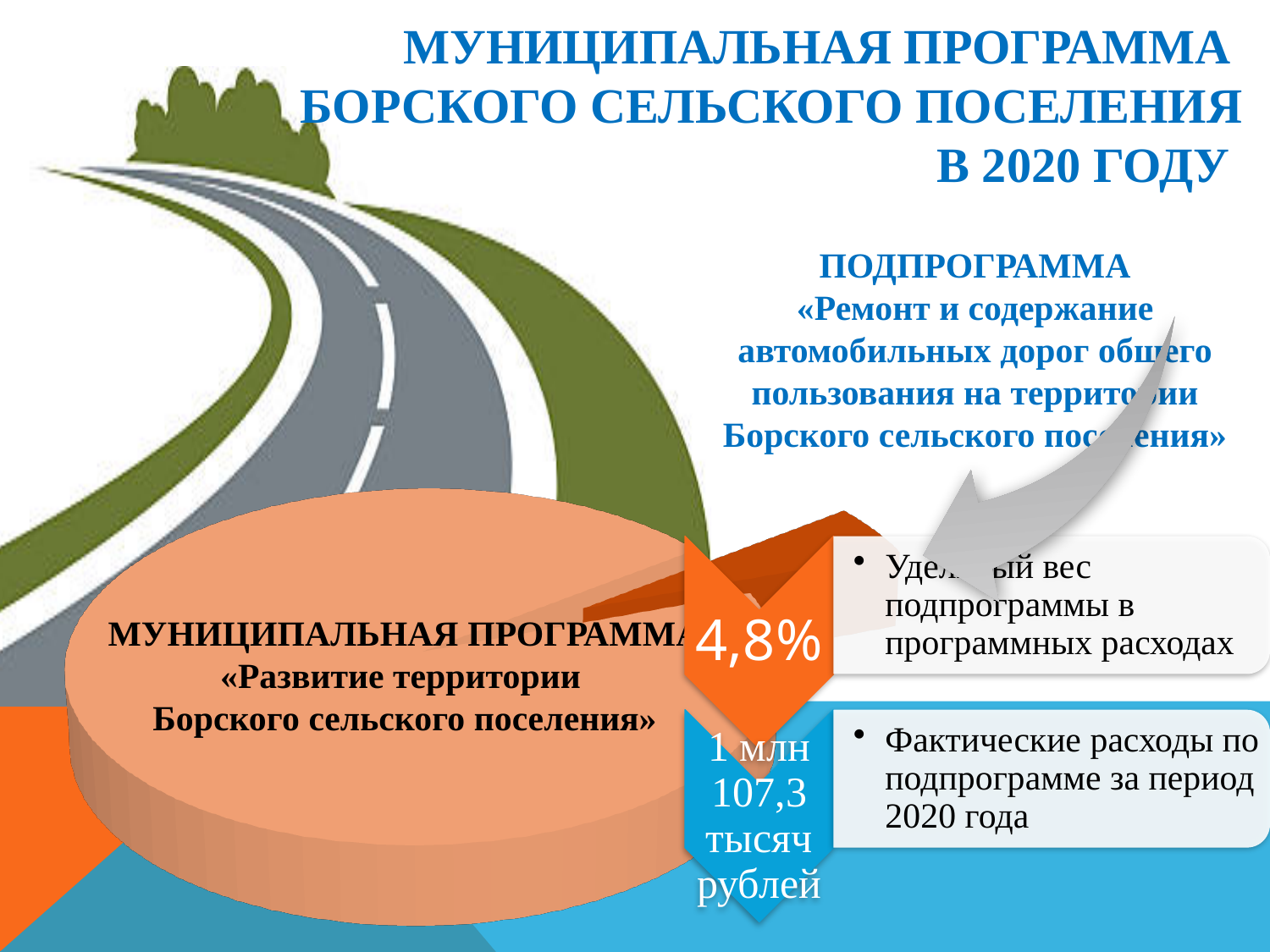
Which is larger in the pie chart: the slice for the subprogramme or the rest of the municipal programme «Развитие территории Борского сельского поселения»? the rest of the municipal programme What colour is the large slice of the pie chart? peach (light orange/salmon) What kind of chart is shown on the slide? pie chart What are the actual expenses for the subprogramme for 2020 shown next to the chart? 1 млн 107,3 тысяч рублей What is the name of the municipal programme labelled on the pie chart? «Развитие территории Борского сельского поселения» Is the subprogramme's share of programme expenses greater or less than 10%? less What share of the programme expenses does the subprogramme «Ремонт и содержание автомобильных дорог общего пользования» account for, according to the chart? 4,8%